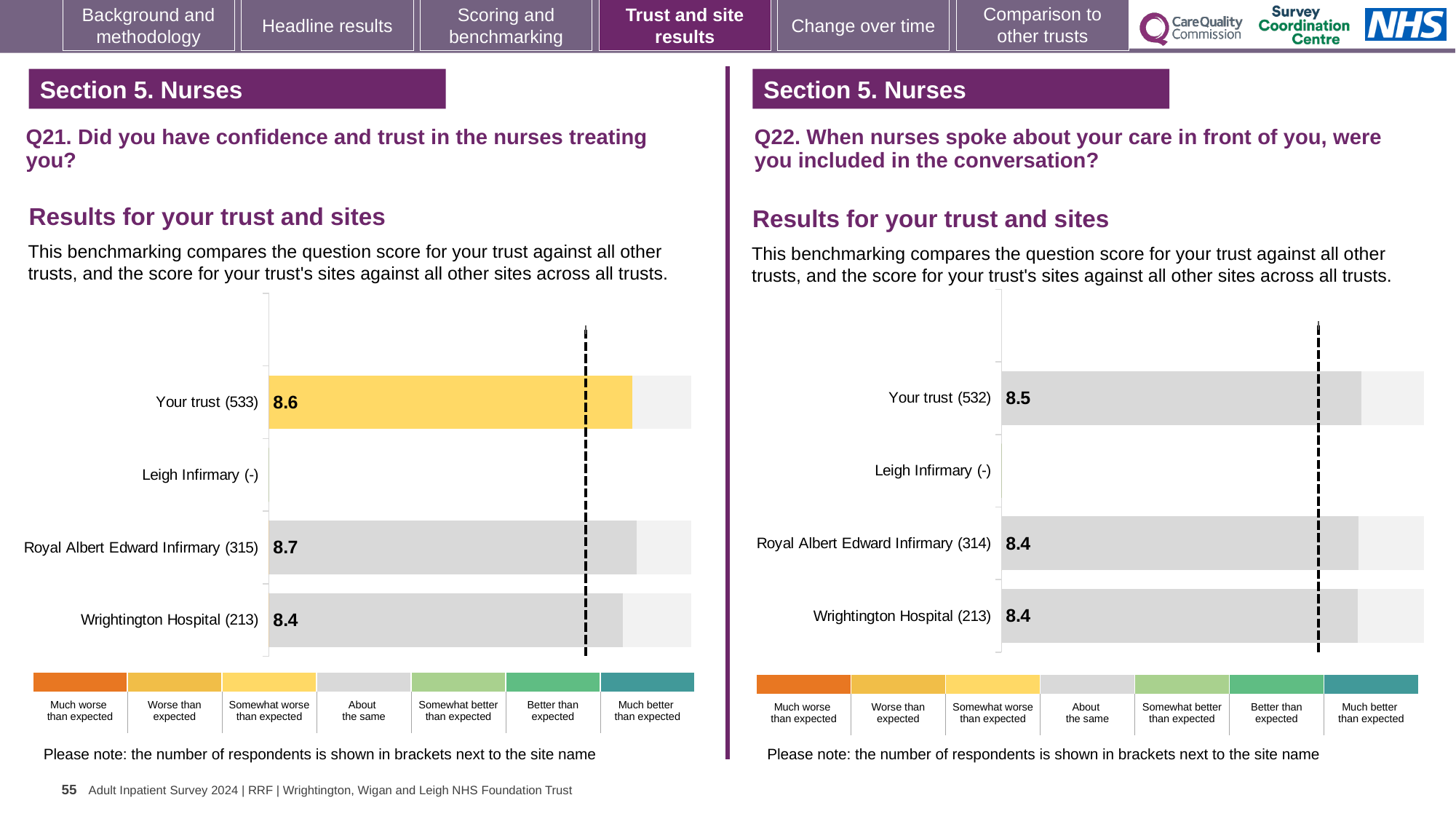
In the Q22 chart on the right, what is the score for Your trust? 8.5 In the Q22 chart on the right, which has the higher score, Your trust or Wrightington Hospital? Your trust In the Q21 chart on the left, what is the difference between the scores for Royal Albert Edward Infirmary and Wrightington Hospital? 0.3 In the Q21 chart on the left, which site or trust has the highest score? Royal Albert Edward Infirmary In the Q21 chart on the left, which site or trust has the lowest score shown? Wrightington Hospital In the Q21 chart on the left, what is the score for Royal Albert Edward Infirmary? 8.7 In the Q21 chart on the left, what is the score for Your trust? 8.6 In the Q22 chart on the right, what is the score for Royal Albert Edward Infirmary? 8.4 In the Q21 chart on the left, how many respondents are shown in brackets for Your trust? 533 In the Q21 chart on the left, what is the score for Wrightington Hospital? 8.4 What type of chart is used for the Q21 results on the left? Bar chart How many sites or trusts are listed on the y axis of the Q22 chart on the right? 4